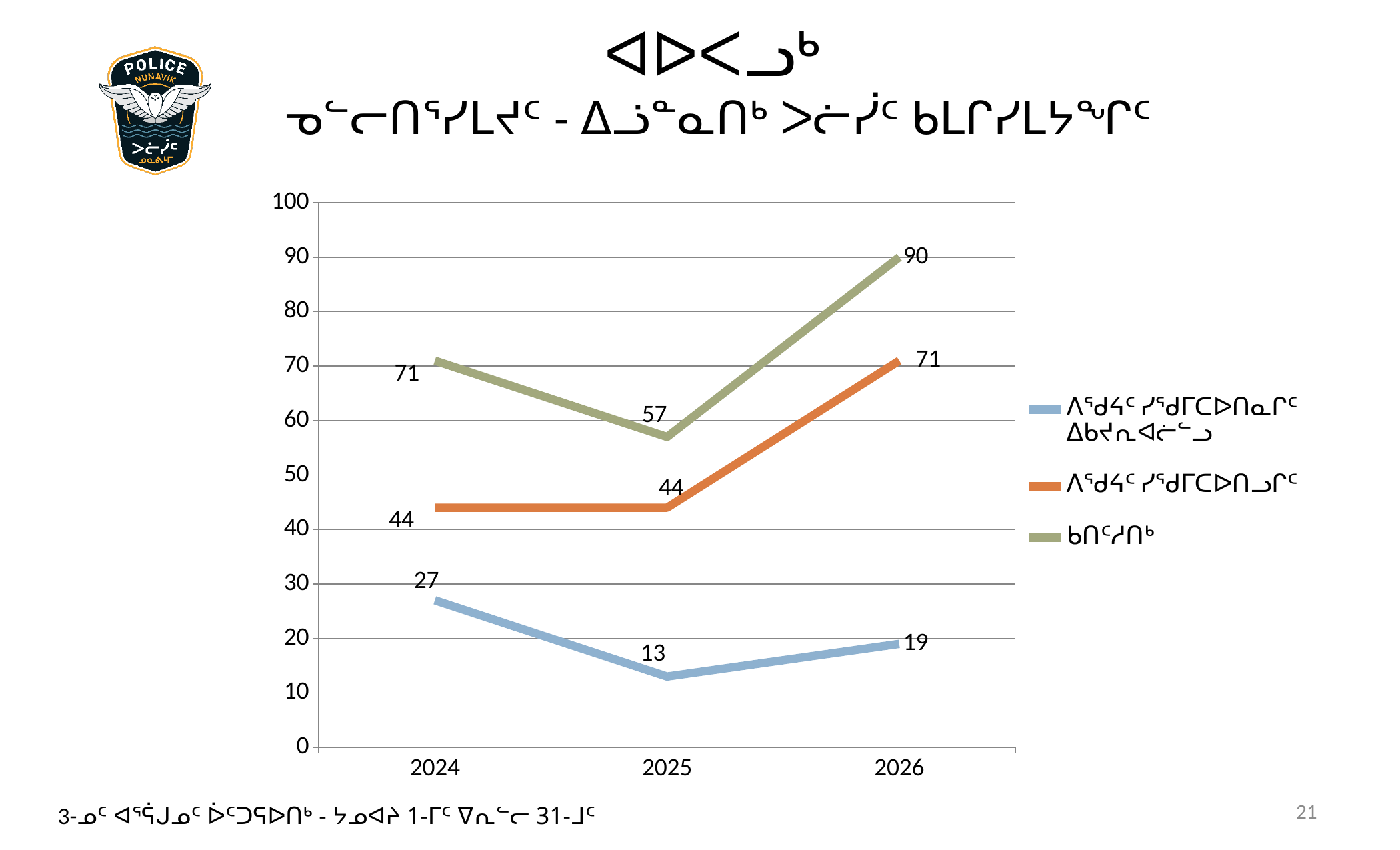
What is the difference between the orange line's 2026 value and its 2024 value? 27 How many years are plotted along the x axis? 3 In 2024, which is larger: the orange line or the blue line? the orange line By how much does the green line increase from 2025 to 2026? 33 Does the blue line rise or fall from 2024 to 2025? fall What kind of chart is shown on the slide? line chart In which year does the green line reach its highest value? 2026 In which year does the blue line reach its lowest value? 2025 What is the value of the green line in 2026? 90 What is the value of the blue line in 2025? 13 What is the value of the orange line in 2024? 44 How many series does the legend list? 3